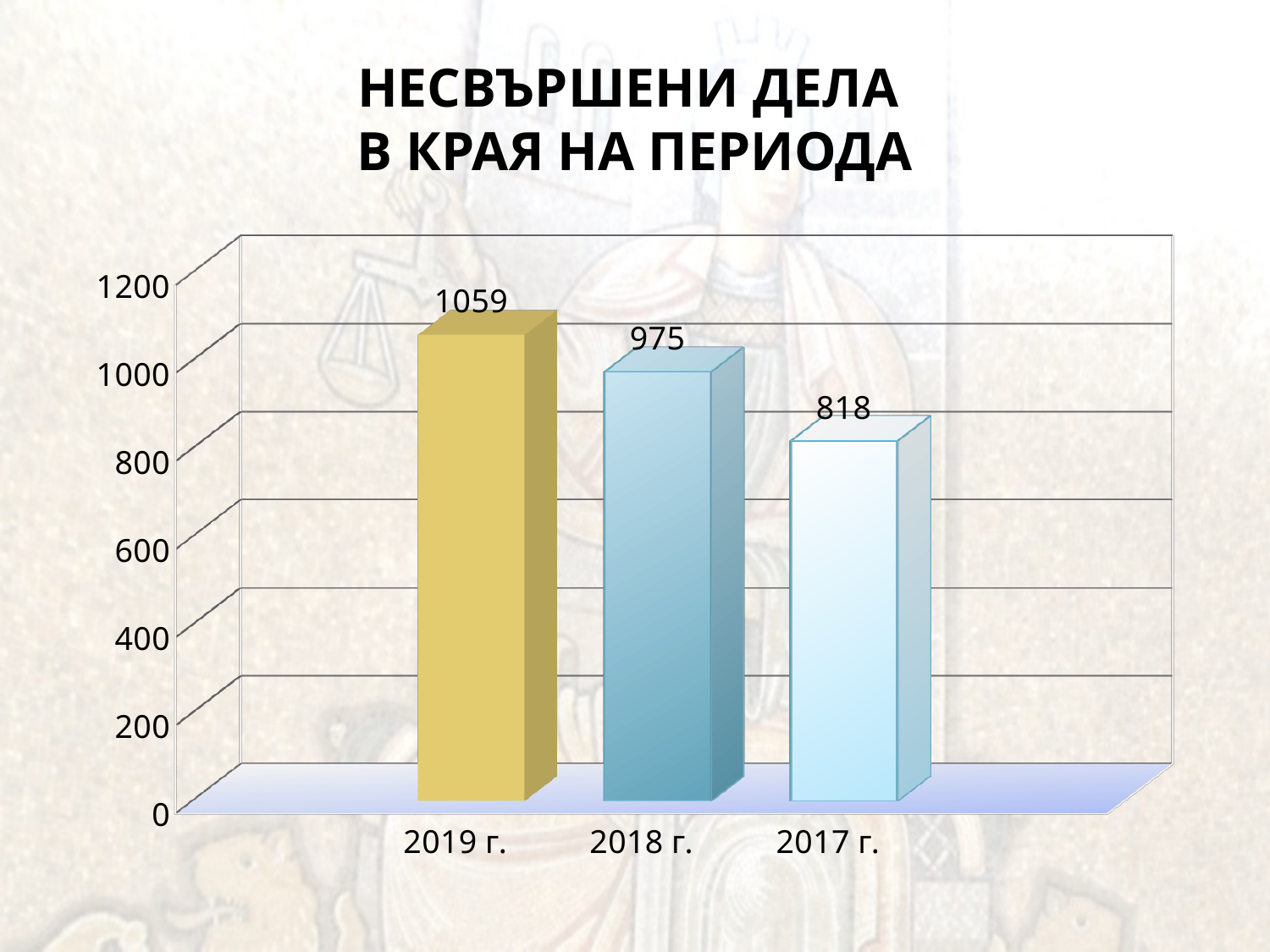
What is the value for 2019 г.? 1059 What is the value for 2017 г.? 818 Which is larger, the value for 2018 г. or the value for 2017 г.? 2018 г. What is the difference between the values for 2019 г. and 2018 г.? 84 What is the difference between the values for 2018 г. and 2017 г.? 157 What is the title of the chart? НЕСВЪРШЕНИ ДЕЛА В КРАЯ НА ПЕРИОДА Which year has the lowest value? 2017 г. Which year has the highest value? 2019 г. What is the value for 2018 г.? 975 What kind of chart is shown on the slide? bar chart How many categories are shown on the chart? 3 Is the value for 2017 г. greater or less than 1000? less